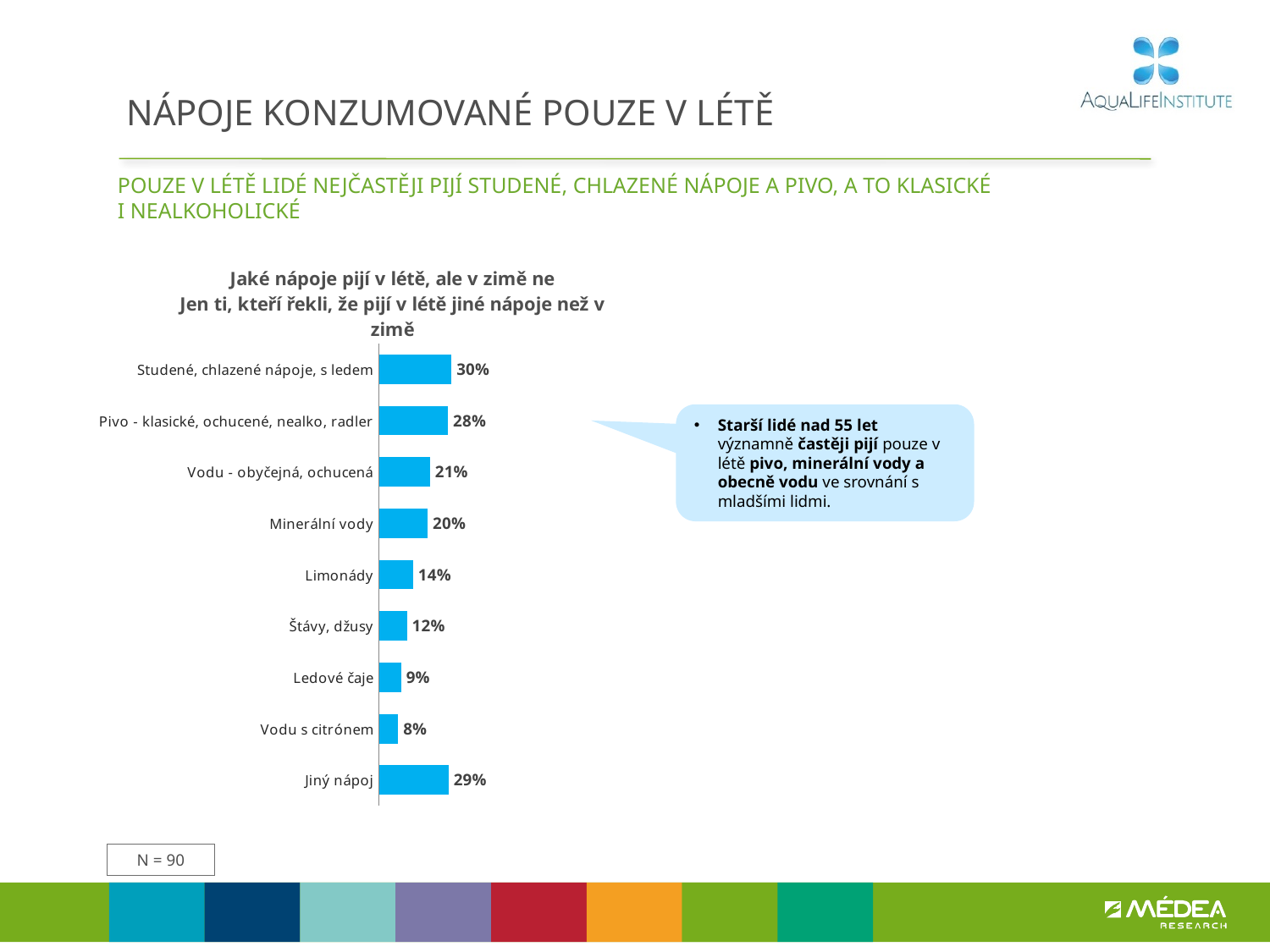
Which category has the highest value? Studené, chlazené nápoje, s ledem What is the difference between the values for "Studené, chlazené nápoje, s ledem" and "Jiný nápoj"? 1% What is the value for "Ledové čaje"? 9% What sample size (N) is stated on the slide for the chart? N = 90 What is the value for "Jiný nápoj"? 29% Which category has the lowest value? Vodu s citrónem What is the value for "Studené, chlazené nápoje, s ledem"? 30% What is the difference between the values for "Pivo - klasické, ochucené, nealko, radler" and "Limonády"? 14% What kind of chart is shown on the slide? Bar chart How many categories are shown in the chart? 9 Which is larger, the value for "Vodu - obyčejná, ochucená" or the value for "Štávy, džusy"? Vodu - obyčejná, ochucená What is the value for "Minerální vody"? 20%